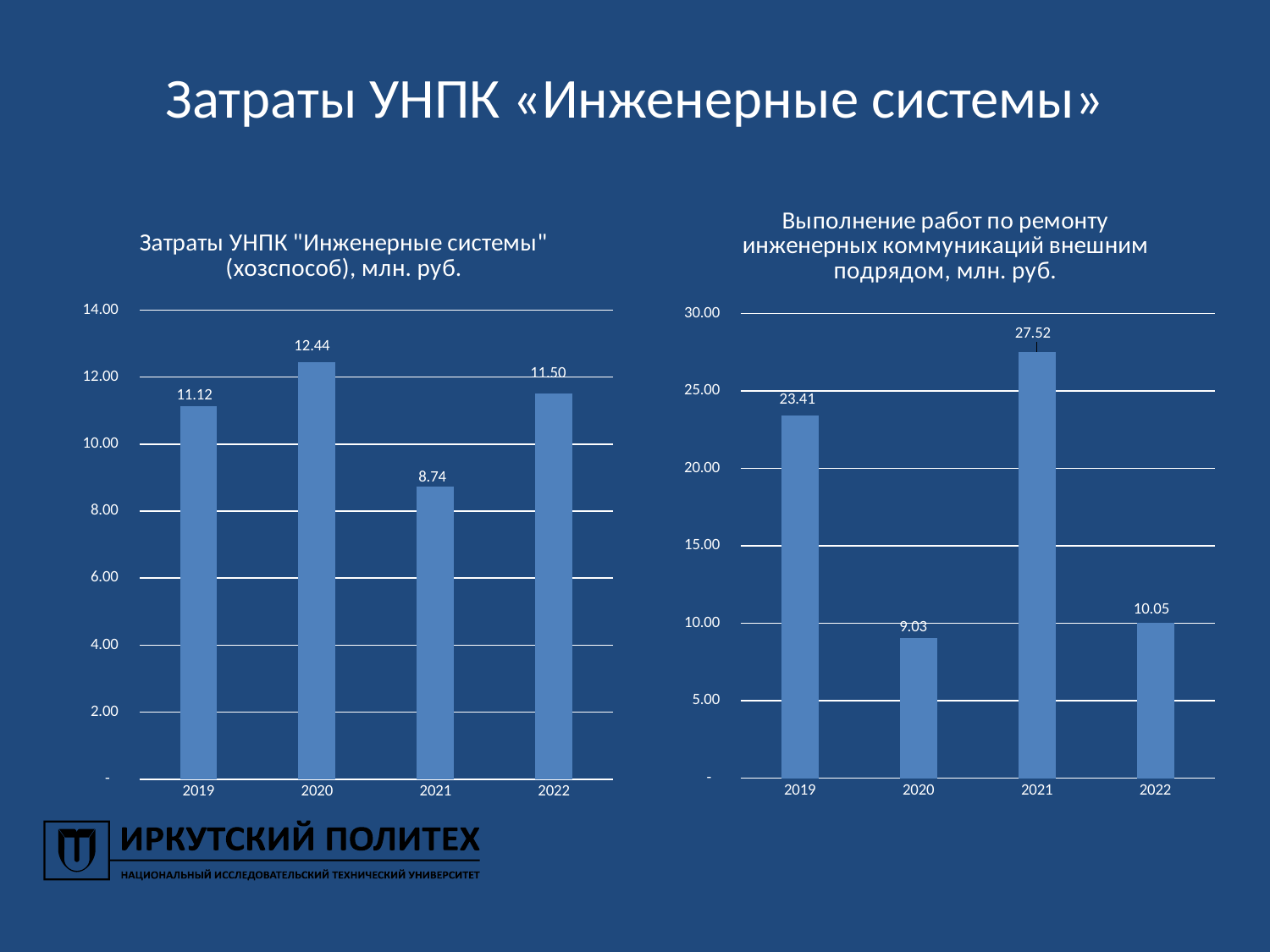
In the right chart (Выполнение работ по ремонту инженерных коммуникаций внешним подрядом), what is the value for 2022? 10.05 In the right chart (Выполнение работ по ремонту инженерных коммуникаций внешним подрядом), which year has the highest value? 2021 How many years are shown on the x axis of the left chart (Затраты УНПК "Инженерные системы" (хозспособ))? 4 In the left chart (Затраты УНПК "Инженерные системы" (хозспособ)), what is the difference between the 2020 and 2021 values? 3.70 What kind of chart is the right chart (Выполнение работ по ремонту инженерных коммуникаций внешним подрядом)? Bar chart In the left chart (Затраты УНПК "Инженерные системы" (хозспособ)), which year has the highest value? 2020 In the left chart (Затраты УНПК "Инженерные системы" (хозспособ)), which year has the lowest value? 2021 In the right chart (Выполнение работ по ремонту инженерных коммуникаций внешним подрядом), what is the value for 2019? 23.41 In the left chart (Затраты УНПК "Инженерные системы" (хозспособ)), what is the value for 2020? 12.44 In the right chart (Выполнение работ по ремонту инженерных коммуникаций внешним подрядом), which is larger: the value for 2019 or the value for 2022? 2019 In the right chart (Выполнение работ по ремонту инженерных коммуникаций внешним подрядом), which year has the lowest value? 2020 In the left chart (Затраты УНПК "Инженерные системы" (хозспособ)), what is the value for 2021? 8.74